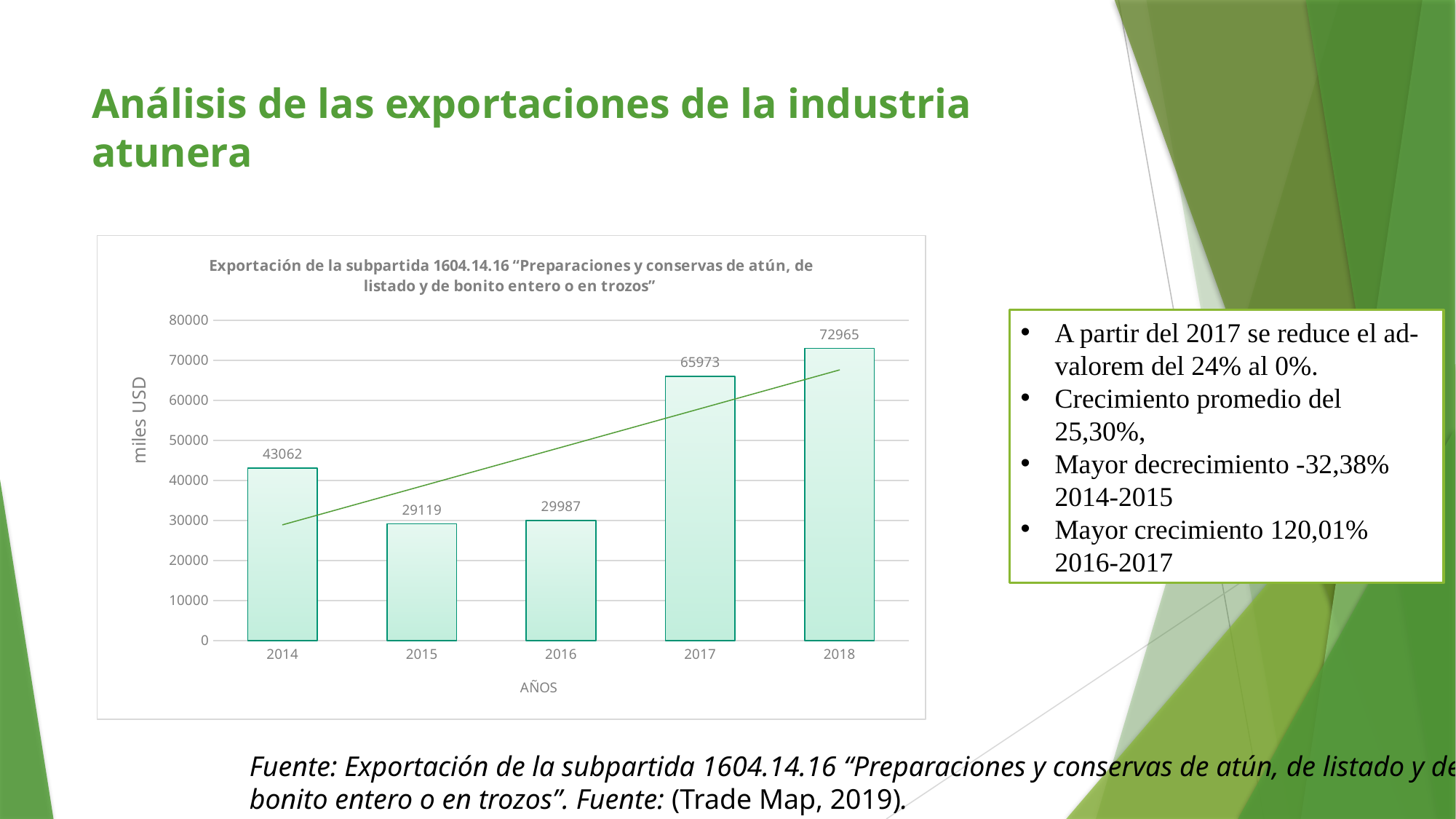
What is the export value for 2016? 29987 What is the export value for 2014? 43062 What is the export value for 2017? 65973 Which year has the lowest export value? 2015 How many years are shown on the x axis? 5 Which year has the highest export value? 2018 What kind of chart is shown on the slide? bar chart What is the difference between the export values for 2018 and 2017? 6992 What is the difference between the export values for 2014 and 2015? 13943 Which year has a larger export value, 2014 or 2016? 2014 Is the value for 2017 greater or less than 60000? greater What is the label of the y axis? miles USD